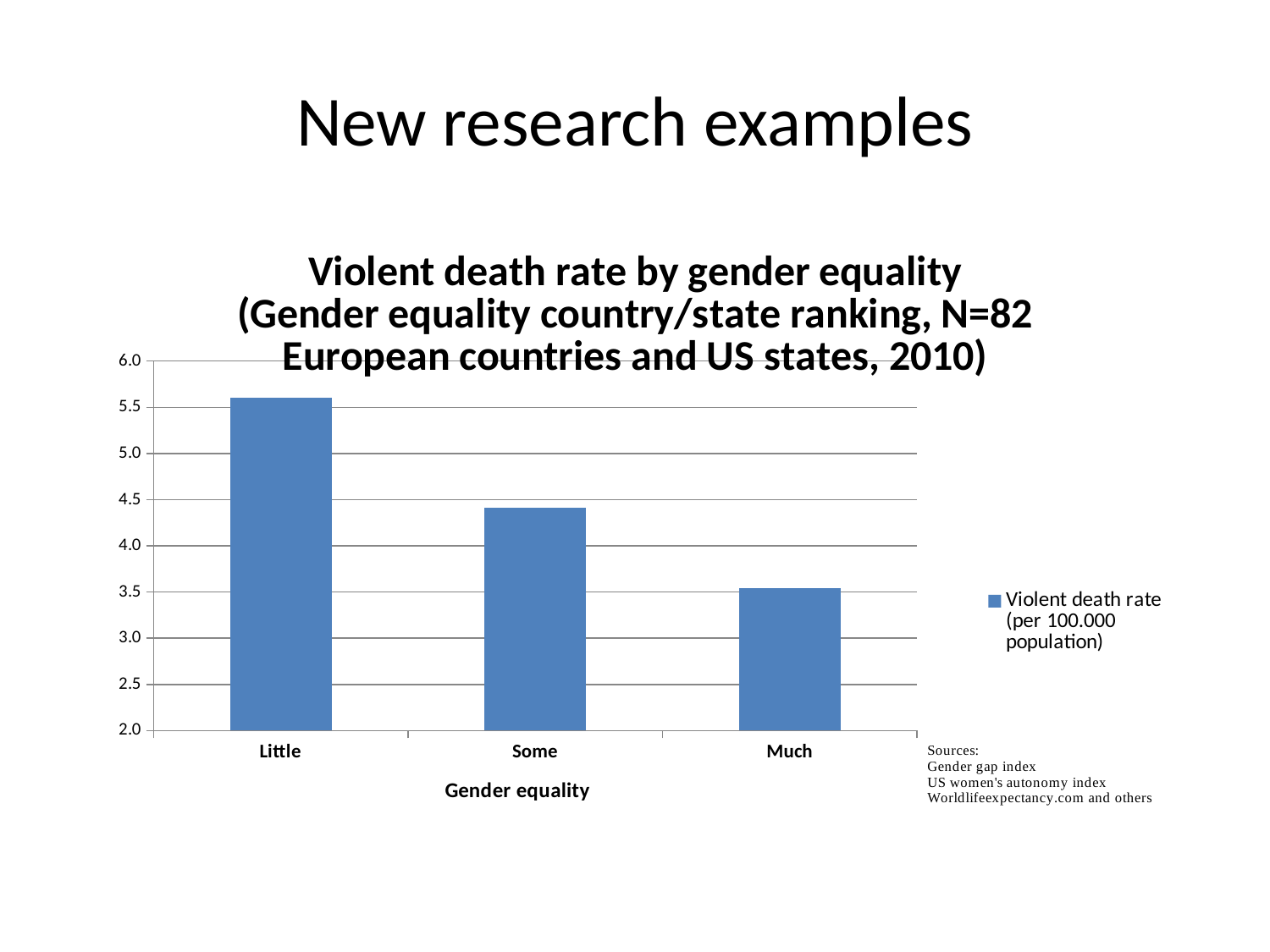
How many series does the legend list? 1 Is the value for Much greater or less than 3.0? greater Which gender equality category has the highest violent death rate? Little Is the value for Much greater or less than 4.0? less Which gender equality category has the lowest violent death rate? Much Which has a higher violent death rate, Little or Some gender equality? Little Is the value for Little greater or less than 5.0? greater How many gender equality categories are shown on the x axis? 3 Do the values rise or fall from Little to Much gender equality? fall Which has a higher violent death rate, Some or Much gender equality? Some What kind of chart is shown on the slide? bar chart